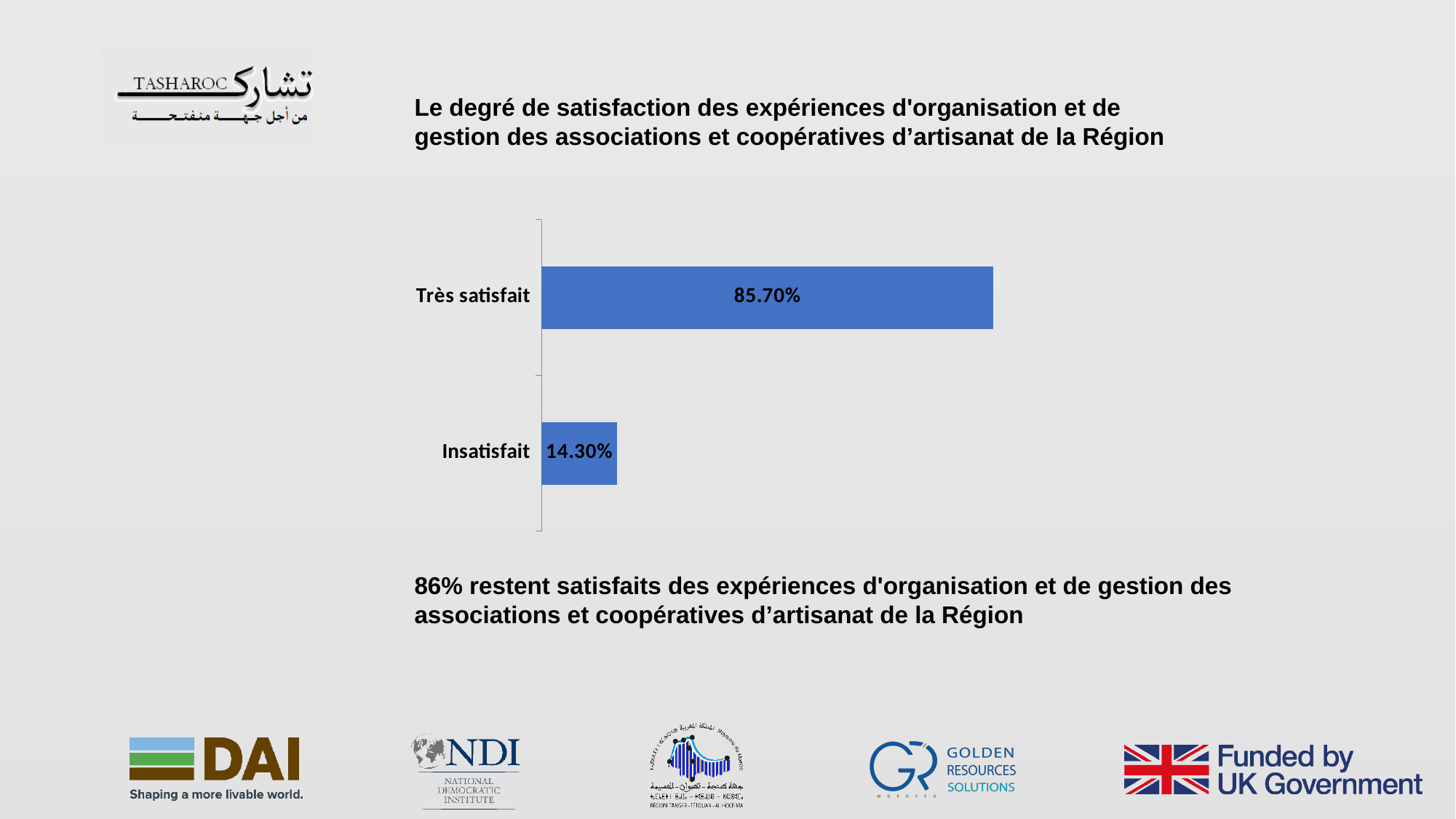
Which category has the lowest value? Insatisfait What is the value for Très satisfait? 85.70% Are the bars in the chart horizontal or vertical? Horizontal What is the total of the two values shown in the chart? 100.00% How many categories are shown in the chart? 2 Which category has the highest value? Très satisfait What is the value for Insatisfait? 14.30% Which is larger, the value for Très satisfait or the value for Insatisfait? Très satisfait What colour are the bars in the chart? Blue What kind of chart is shown on the slide? Bar chart What is the difference between the values for Très satisfait and Insatisfait? 71.40%